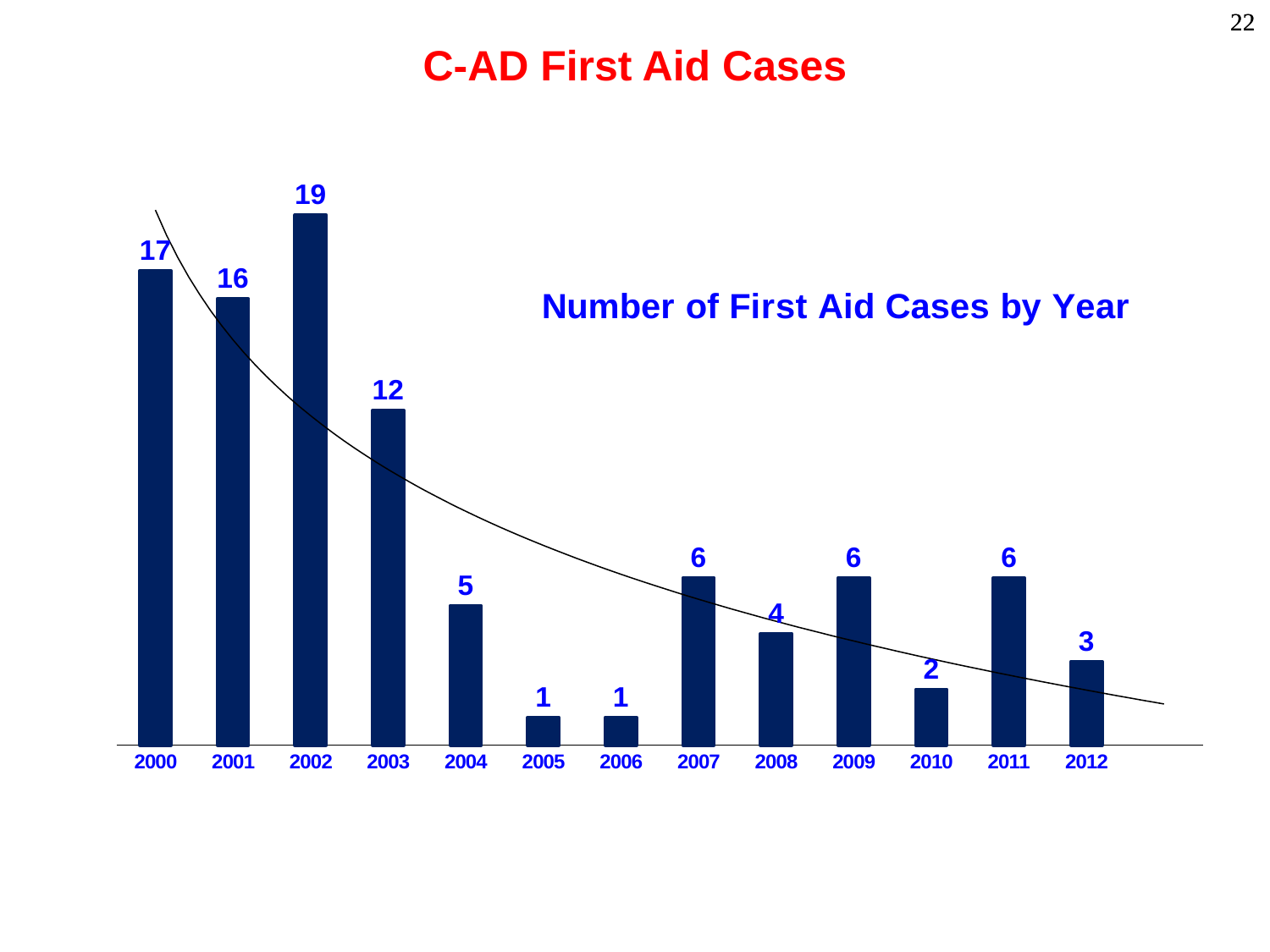
What kind of chart is used to show the number of first aid cases by year? Bar chart Which year has the highest number of first aid cases? 2002 What is the difference between the number of first aid cases in 2000 and in 2012? 14 How many first aid cases were there in 2002? 19 What is the number of first aid cases shown for 2003? 12 What is the title of the slide? C-AD First Aid Cases Which years have the lowest number of first aid cases? 2005 and 2006 What is the difference in first aid cases between 2002 and 2003? 7 Which year had more first aid cases, 2008 or 2011? 2011 Overall, do the number of first aid cases rise or fall from 2000 to 2012? Fall How many years are shown on the x axis of the chart? 13 How many first aid cases are shown for 2010? 2